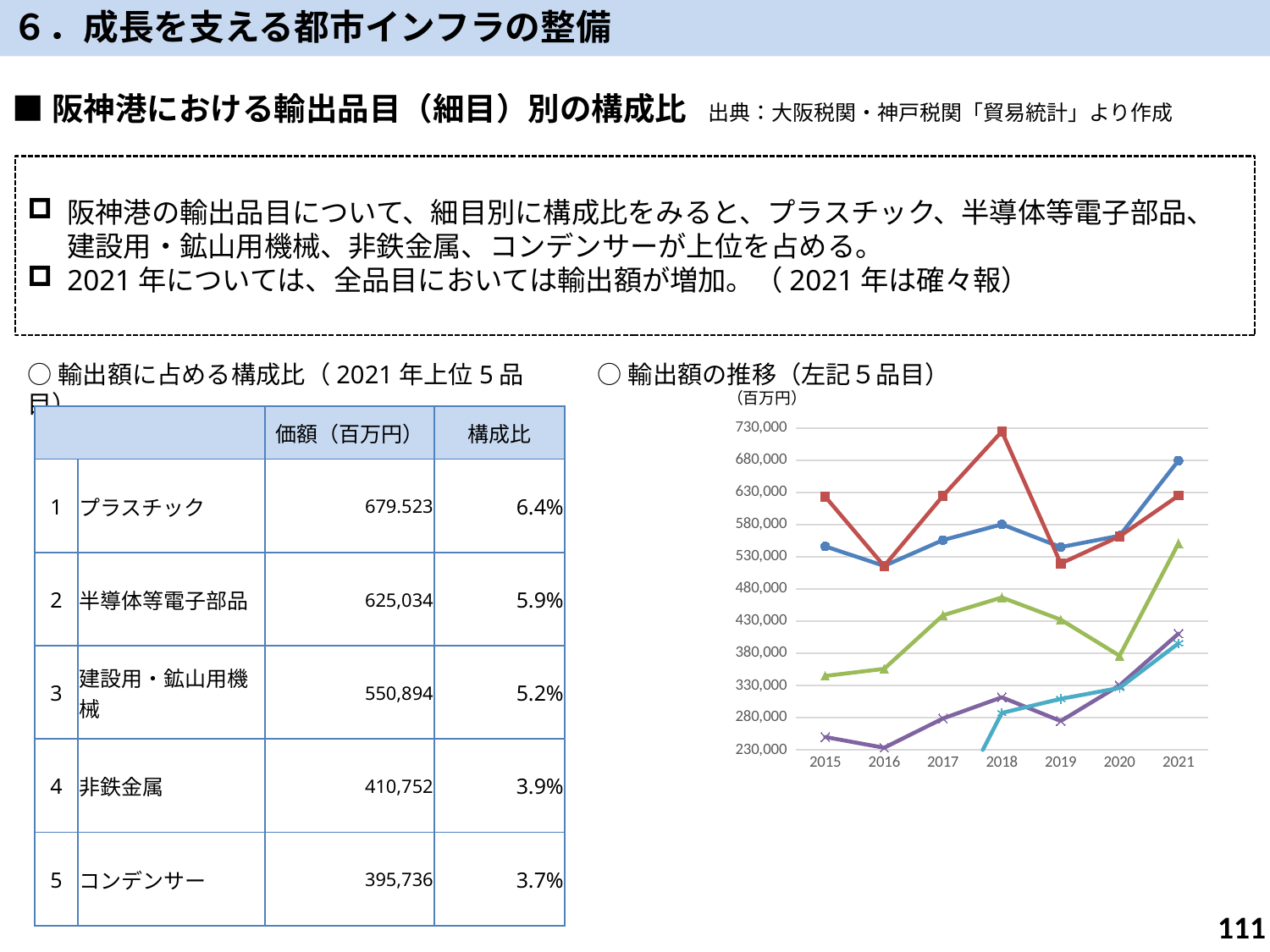
In the 輸出額の推移 chart, is the red line's value in 2018 greater or less than 680,000? greater In the 輸出額の推移 chart, which line is higher in 2018, the red line or the blue line? the red line What kind of chart is the 輸出額の推移（左記５品目） chart? line chart How many lines are plotted on the 輸出額の推移 chart? 5 How many years are shown on the x axis of the 輸出額の推移 chart? 7 In the 輸出額の推移 chart, is the purple line's value in 2016 greater or less than 280,000? less In the 輸出額の推移 chart, does the green line rise or fall from 2020 to 2021? rise In the 輸出額の推移 chart, in which year does the blue line reach its highest point? 2021 What unit is shown above the y axis of the 輸出額の推移 chart? 百万円 In the 輸出額の推移 chart, in which year does the red line reach its highest point? 2018 In the 輸出額の推移 chart, in which year is the green line at its lowest? 2015 In the 輸出額の推移 chart, is the green line's value in 2018 greater or less than 430,000? greater